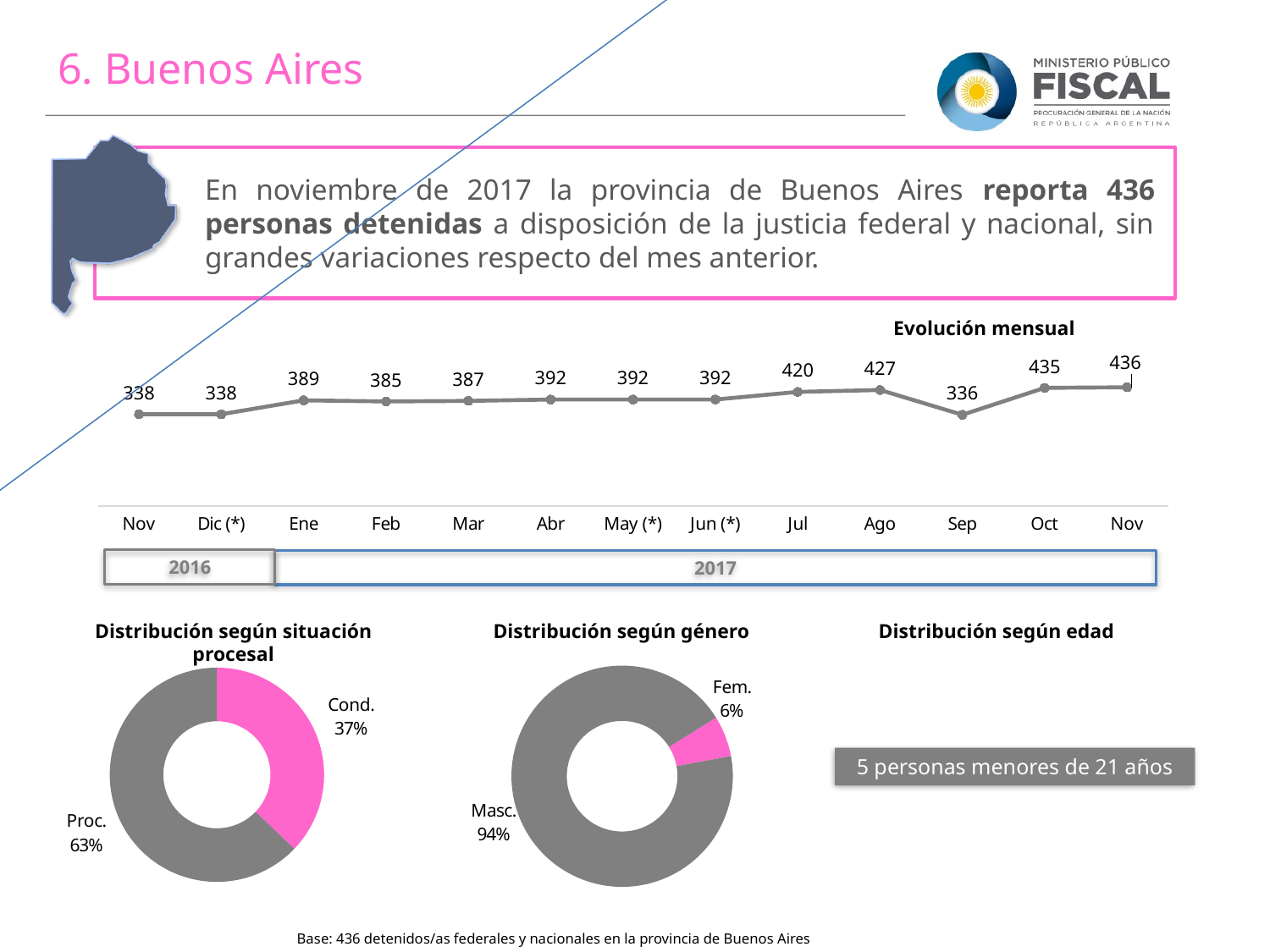
In the 'Distribución según situación procesal' chart, what share is Cond.? 37% In the 'Distribución según género' chart, what share is Masc.? 94% What kind of chart is 'Evolución mensual'? Line chart In the 'Evolución mensual' chart, what is the difference between the values for Oct and Sep? 99 In the 'Evolución mensual' chart, which month has the lowest value? Sep In the 'Evolución mensual' chart, do the values rise or fall from Sep to Nov 2017? Rise In the 'Evolución mensual' chart, which is larger, the value for Jul or the value for Feb? Jul How many data points are plotted in the 'Evolución mensual' chart? 13 In the 'Evolución mensual' chart, what is the value for Sep? 336 In the 'Distribución según género' chart, what is the difference between the Masc. and Fem. shares? 88% In the 'Evolución mensual' chart, what is the value for Ago? 427 In the 'Evolución mensual' chart, which month has the highest value? Nov (2017)